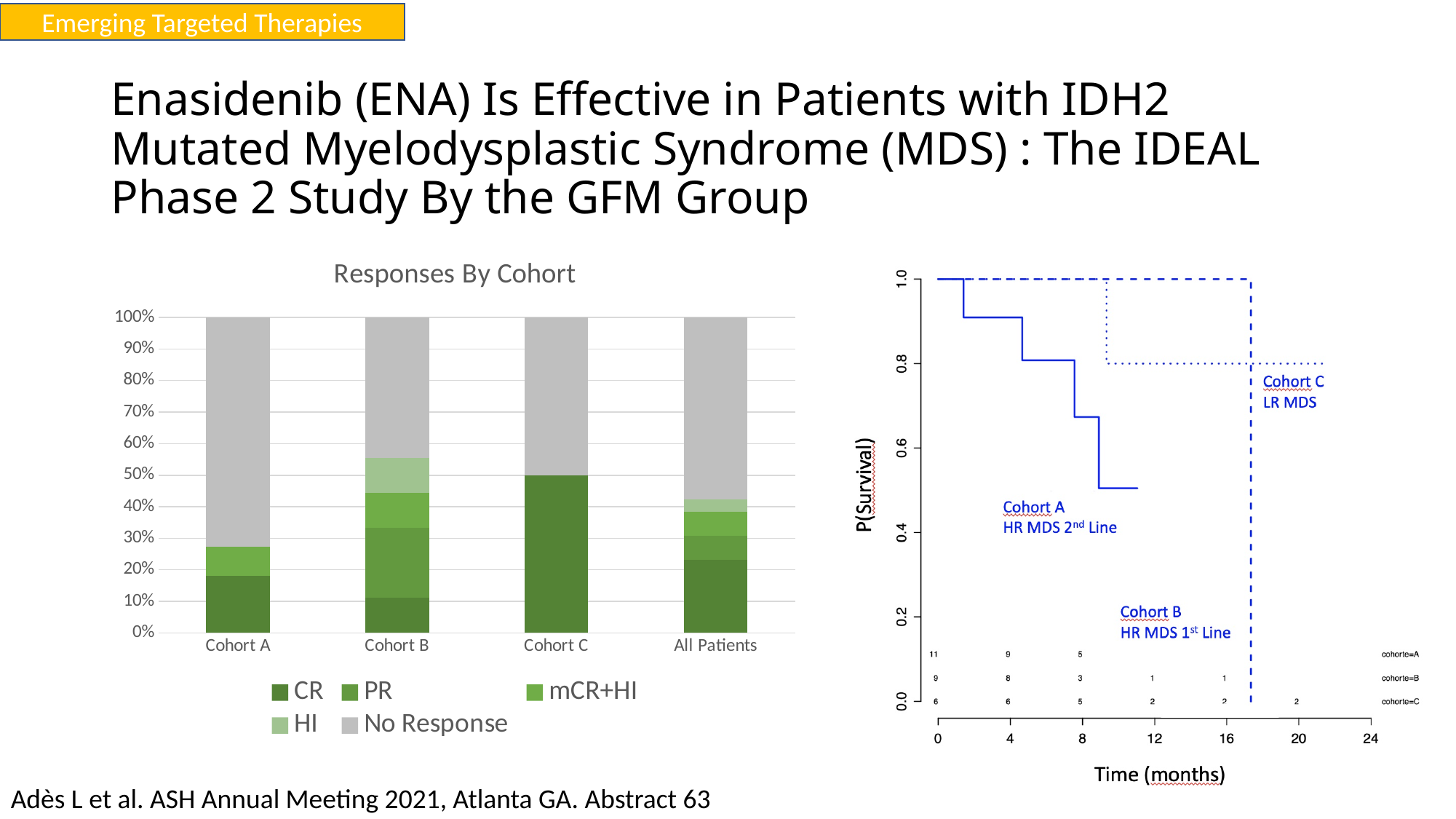
In the 'Responses By Cohort' chart, is the CR value for Cohort A greater or less than 20%? less In the 'Responses By Cohort' chart, is the CR value for Cohort B greater or less than 20%? less In the 'Responses By Cohort' chart, what is the CR value for Cohort C? 50% In the 'Responses By Cohort' chart, which series is shown in grey? No Response In the 'Responses By Cohort' chart, which category has the largest No Response segment? Cohort A How many series does the legend of the 'Responses By Cohort' chart list? 5 In the 'Responses By Cohort' chart, is the CR value for Cohort B larger or smaller than the CR value for Cohort A? smaller How many cohort categories are shown on the x axis of the 'Responses By Cohort' chart? 4 What kind of chart is the 'Responses By Cohort' chart on the left? Stacked bar chart In the 'Responses By Cohort' chart, which cohort has the largest CR segment? Cohort C In the survival chart on the right, how many patients in cohort A are at risk at time 0? 11 In the survival chart on the right, what is the label of the x axis? Time (months)